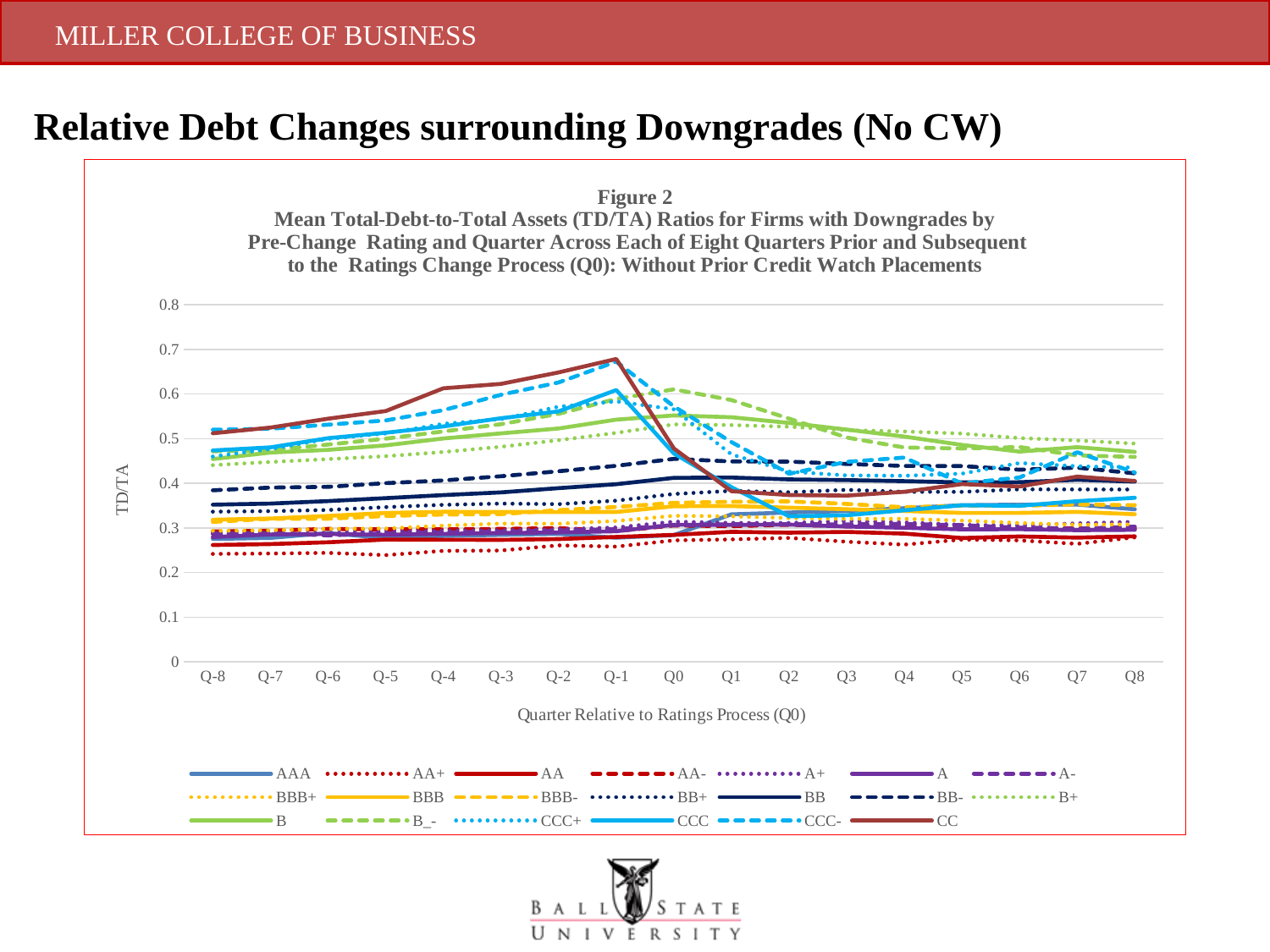
Is the value for AA+ at Q-5 greater or less than 0.3? less Does the CC series rise or fall from Q-8 to Q-1? rise Is the value for CC at Q-1 greater or less than 0.6? greater What kind of chart is shown on the slide? line chart How many quarters are shown along the x axis? 17 What is the label of the y axis? TD/TA Which series has the highest value at Q-4? CC Is the value for CCC at Q2 greater or less than 0.4? less How many series does the legend list? 20 Which series has the lowest value at Q-5? AA+ What is the label of the x axis? Quarter Relative to Ratings Process (Q0)